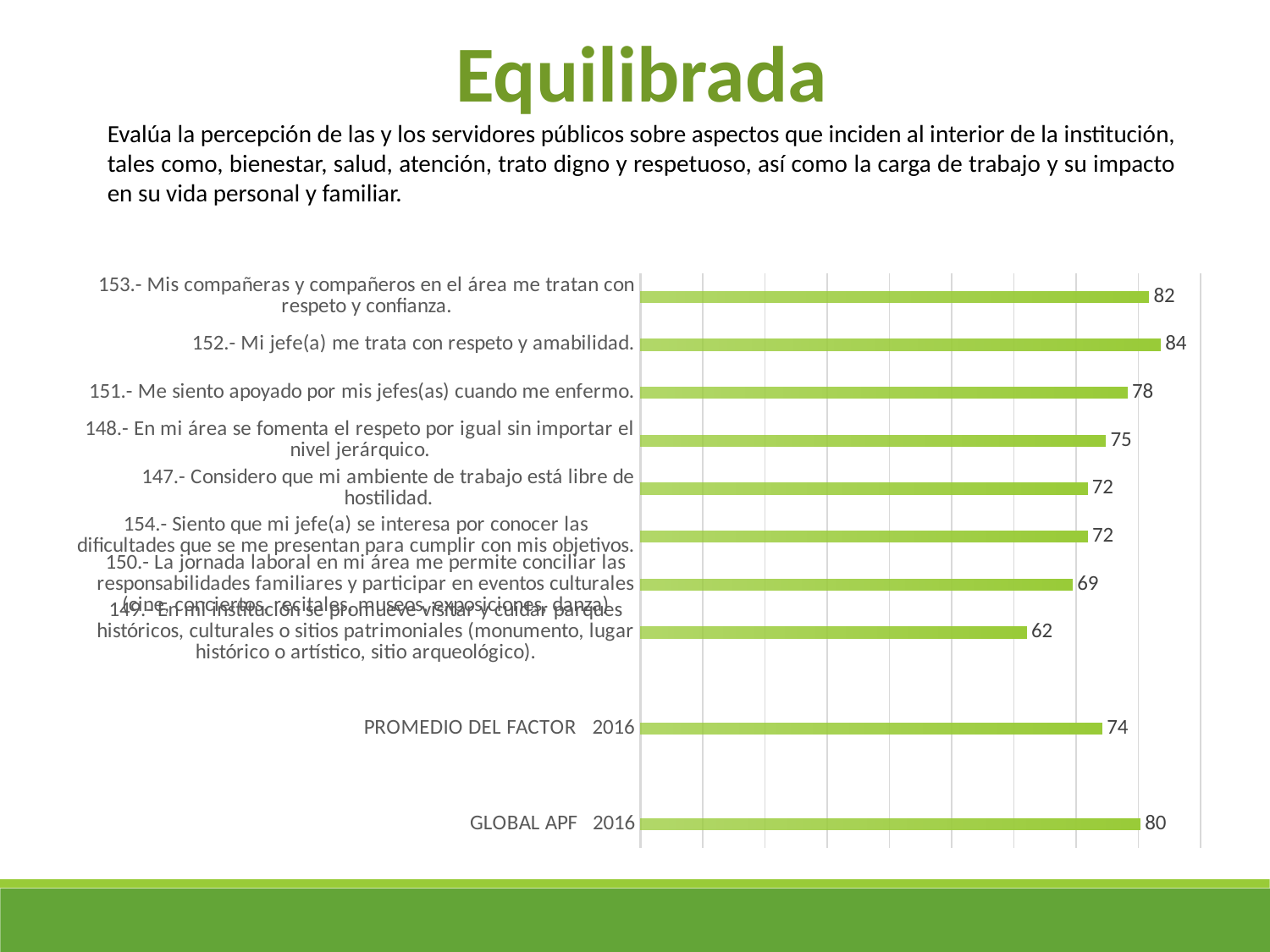
What value is shown for item 151 ("Me siento apoyado por mis jefes(as) cuando me enfermo")? 78 What is the difference between GLOBAL APF 2016 and PROMEDIO DEL FACTOR 2016? 6 Which item has the lowest value in the chart? 149.- En mi institución se promueve visitar y cuidar parques históricos, culturales o sitios patrimoniales Which is larger, the value for item 151 or the value for item 147? 151.- Me siento apoyado por mis jefes(as) cuando me enfermo. What is the difference between the value for item 153 and the value for item 148? 7 What value is shown for PROMEDIO DEL FACTOR 2016? 74 What value is shown for GLOBAL APF 2016? 80 Which item has the highest value in the chart? 152.- Mi jefe(a) me trata con respeto y amabilidad. How many bars are plotted in the chart? 10 What type of chart is shown on the slide? Bar chart What value is shown for item 152 ("Mi jefe(a) me trata con respeto y amabilidad")? 84 What is the title of the slide containing the chart? Equilibrada